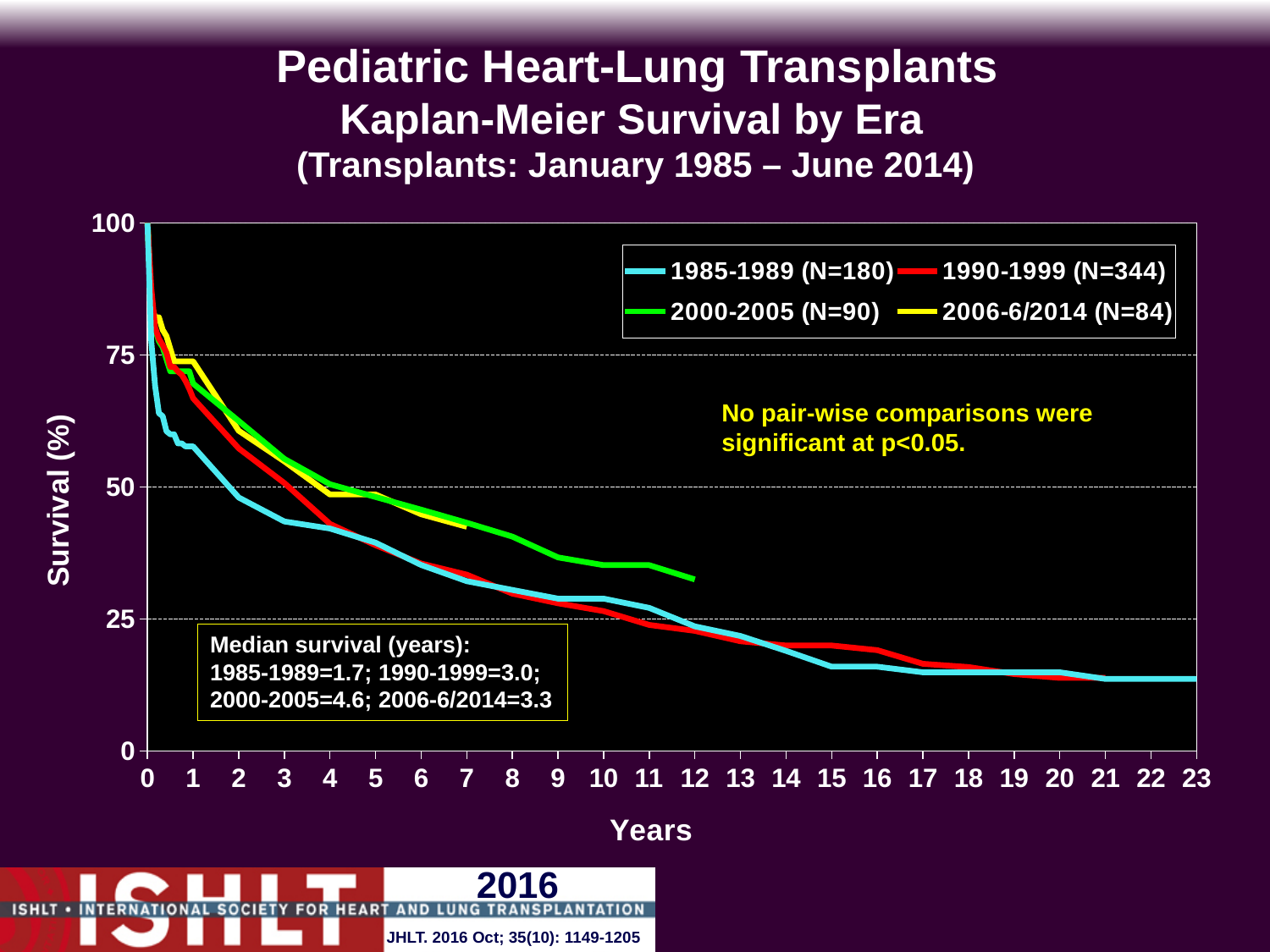
Do the survival curves rise or fall as years increase along the x axis? Fall What kind of chart is shown on the slide? Line chart Which era has the lowest median survival? 1985-1989 What colour is the line for the 2006-6/2014 era? Yellow Is the survival for the 2000-2005 era at 1 year greater or less than 50? greater Which era has the highest median survival? 2000-2005 Which era has the larger N, 1985-1989 or 2000-2005? 1985-1989 What is the median survival in years for the 2000-2005 era? 4.6 How many series (eras) does the legend list? 4 What is the N for the 1990-1999 era shown in the legend? 344 Is the survival for the 1985-1989 era at 5 years greater or less than 50? less What is the difference in median survival (years) between the 2000-2005 era and the 1985-1989 era? 2.9